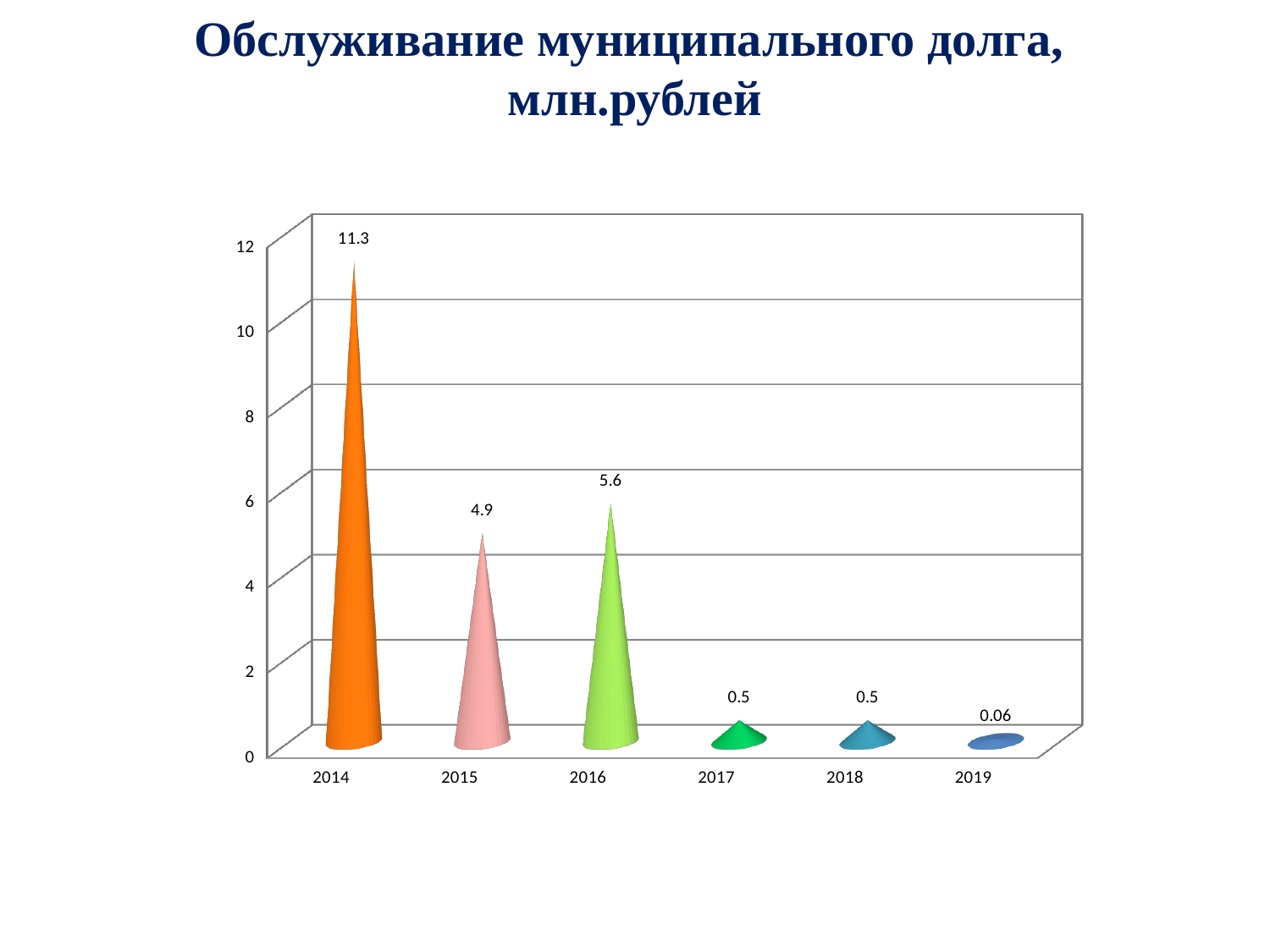
Which year has the lowest value? 2019 What kind of chart is shown on the slide? bar chart What is the difference between the values for 2014 and 2015? 6.4 What is the difference between the values for 2016 and 2017? 5.1 Do the values generally rise or fall from 2014 to 2019? fall What is the value for 2019? 0.06 What is the value for 2014? 11.3 What is the value for 2016? 5.6 Is the value for 2014 greater or less than 10? greater How many years are shown on the x axis? 6 Which is larger, the value for 2015 or the value for 2016? 2016 Which year has the highest value? 2014